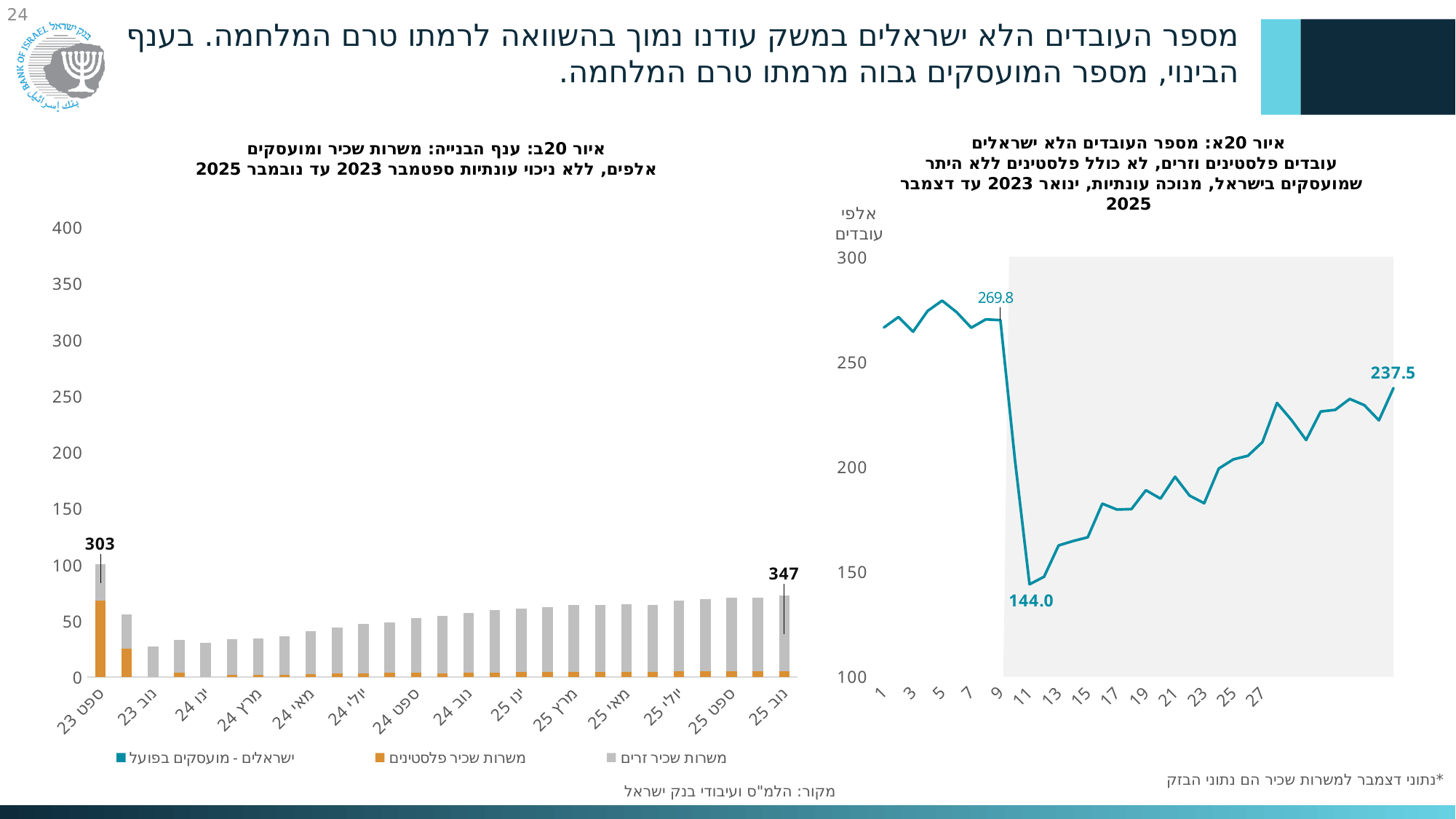
In the left-hand chart (איור 20ב), what is the difference between the labelled values for נוב 25 (347) and ספט 23 (303)? 44 What kind of chart is the right-hand chart (איור 20א)? line chart In the right-hand chart (איור 20א), what value is labelled just before the sharp drop in the line? 269.8 In the right-hand chart (איור 20א), which is larger: the value labelled 269.8 before the drop or the final value labelled 237.5? 269.8 In the left-hand chart (איור 20ב), what value is labelled above the ספט 23 bar? 303 In the right-hand chart (איור 20א), what value is labelled at the last point of the line? 237.5 How many series does the legend of the left-hand chart (איור 20ב) list? 3 In the right-hand chart (איור 20א), what is the lowest labelled value on the line? 144.0 What kind of chart is the left-hand chart (איור 20ב)? bar chart In the right-hand chart (איור 20א), does the line generally rise or fall from point 11 to the end of the series? rise In the right-hand chart (איור 20א), what is the difference between the labelled value before the drop (269.8) and the lowest labelled value (144.0)? 125.8 In the right-hand chart (איור 20א), is the value at point 13 greater or less than 200? less